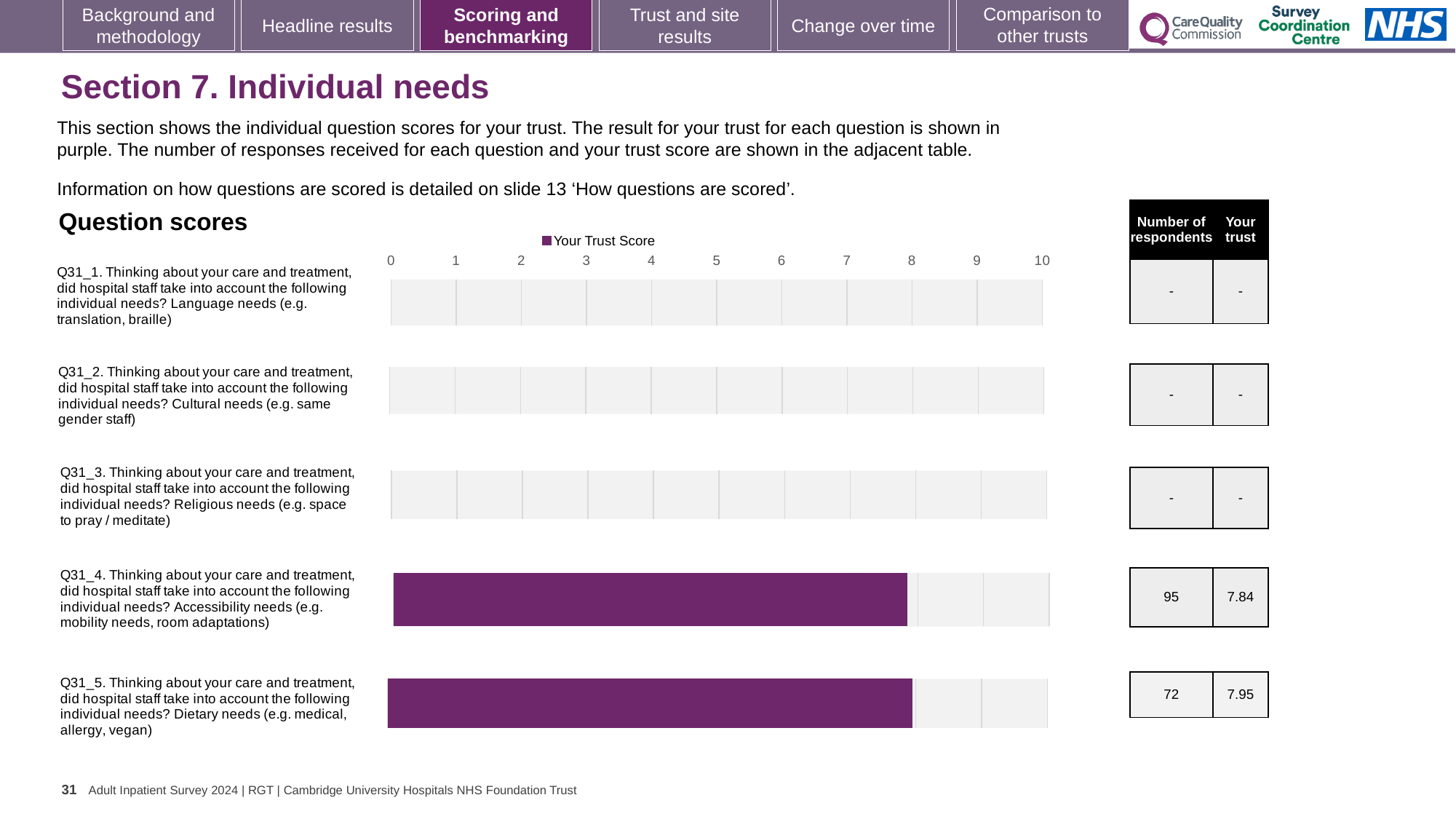
Is the trust score for Q31_4 (Accessibility needs) greater or less than 7? greater How many respondents answered Q31_4 (Accessibility needs)? 95 What is the difference between the trust scores for Q31_5 and Q31_4? 0.11 Which question has the highest trust score shown on the chart? Q31_5 (Dietary needs) What is the trust score for Q31_4 (Accessibility needs)? 7.84 How many respondents answered Q31_5 (Dietary needs)? 72 What kind of chart is shown on the slide? Bar chart How many questions are listed on the chart? 5 What is the maximum value shown on the chart's axis? 10 What is the trust score for Q31_5 (Dietary needs)? 7.95 Which has the larger trust score, Q31_4 (Accessibility needs) or Q31_5 (Dietary needs)? Q31_5 (Dietary needs) How many series does the legend list? 1